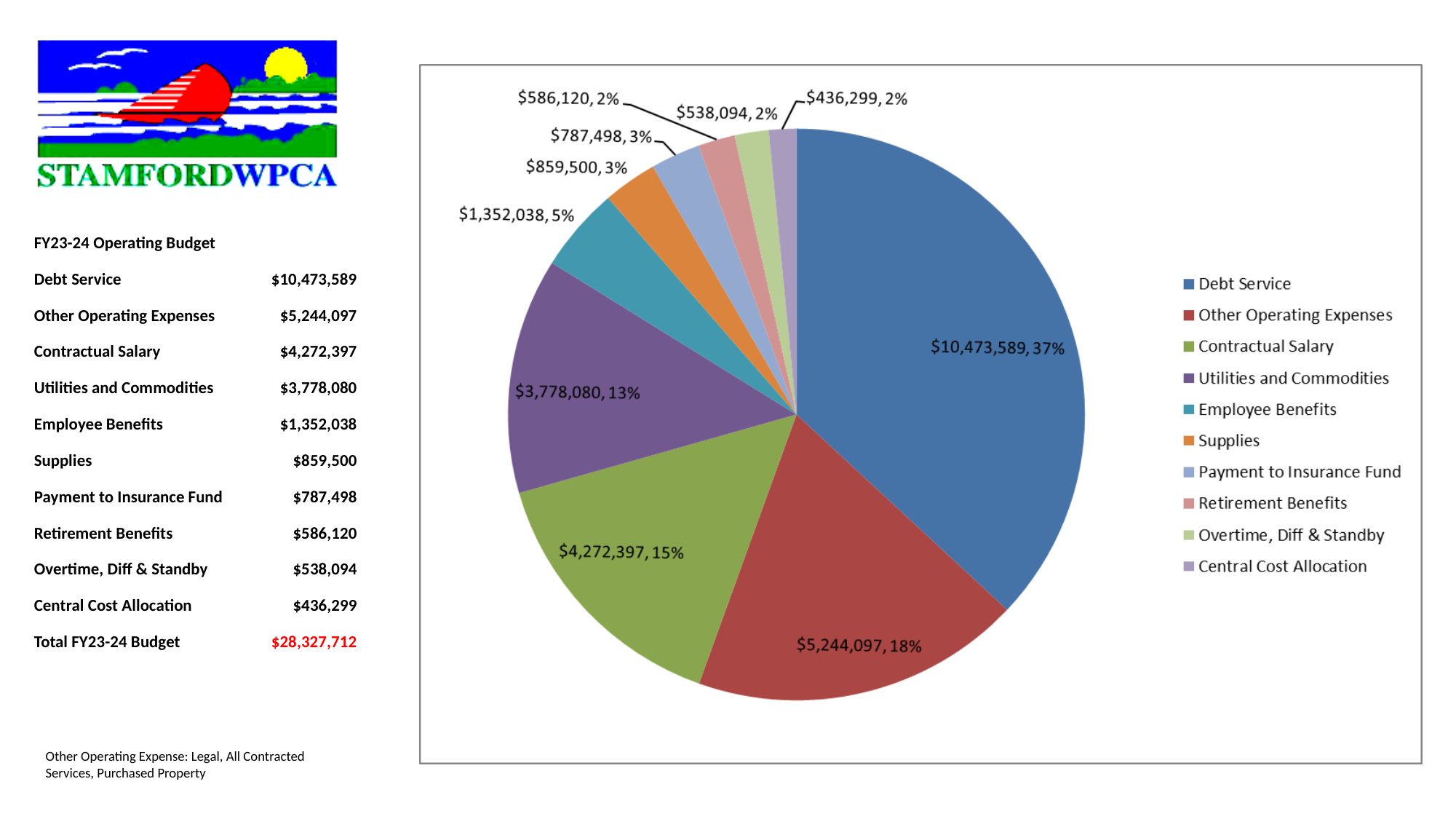
What is the value shown for Utilities and Commodities in the pie chart? $3,778,080 How many categories does the pie chart show? 10 What percentage share of the pie does Other Operating Expenses have? 18% Which is larger, the value for Employee Benefits or the value for Supplies? Employee Benefits What colour is the Debt Service slice in the pie chart? blue What is the difference between the Debt Service value and the Other Operating Expenses value? $5,229,492 Which category has the smallest slice of the pie? Central Cost Allocation What is the value shown for Debt Service in the pie chart? $10,473,589 What percentage share of the pie does Contractual Salary have? 15% Which category has the largest slice of the pie? Debt Service What kind of chart is shown on the slide? pie chart What is the value shown for Payment to Insurance Fund in the pie chart? $787,498